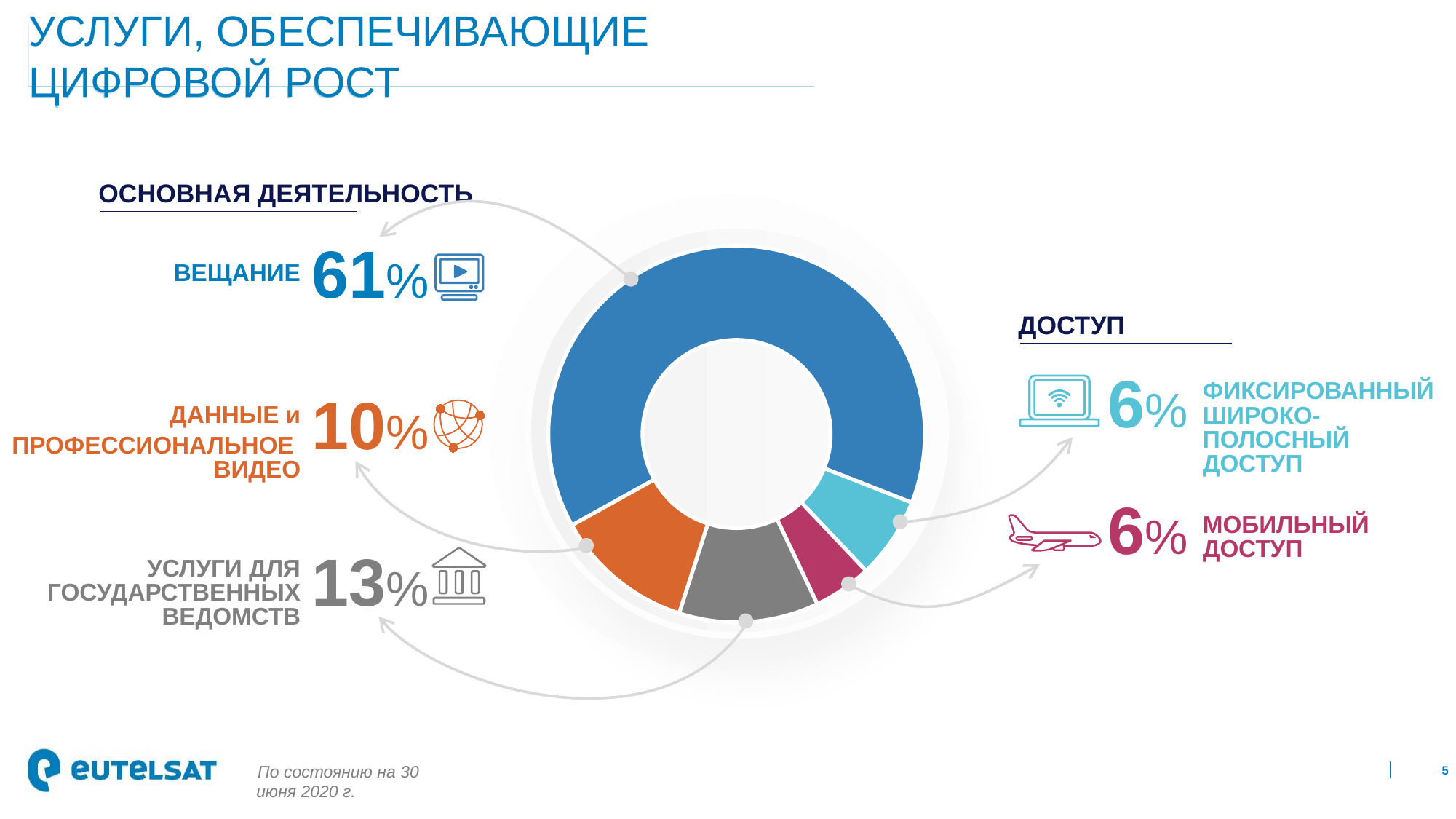
What is the difference in percentage points between Услуги для государственных ведомств and Данные и профессиональное видео? 3% What percentage does the chart show for Услуги для государственных ведомств? 13% Which is larger: Данные и профессиональное видео or Услуги для государственных ведомств? Услуги для государственных ведомств What percentage does the chart show for Мобильный доступ? 6% What percentage does the chart show for Вещание (broadcasting)? 61% How many segments does the chart have? 5 What percentage does the chart show for Данные и профессиональное видео? 10% What is the difference in percentage points between Вещание and Услуги для государственных ведомств? 48% What percentage does the chart show for Фиксированный широкополосный доступ? 6% What colour is the Вещание segment of the chart? Blue Which category has the largest share in the chart? Вещание What kind of chart is shown on the slide? Doughnut chart